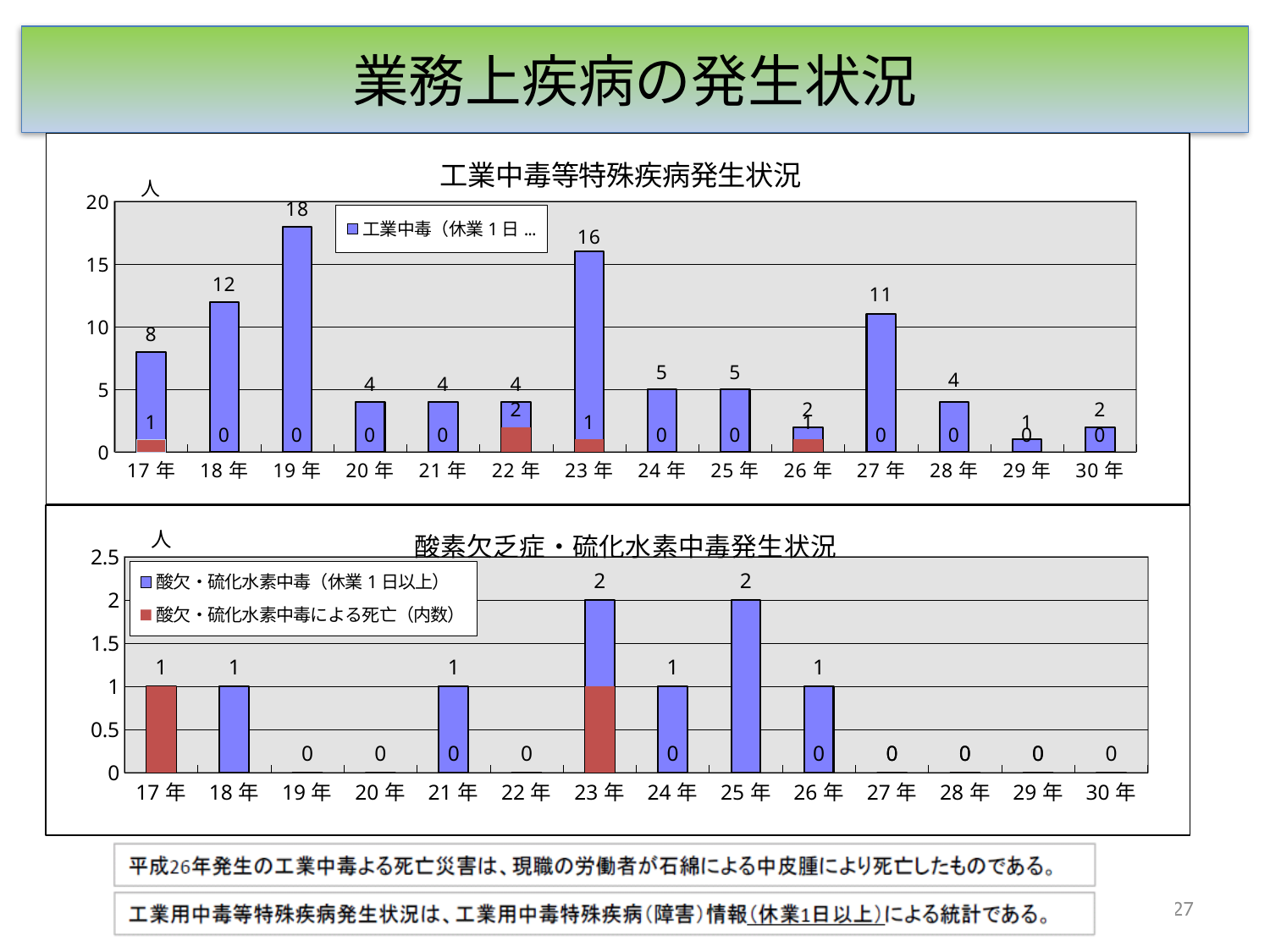
What kind of chart is the bottom chart (酸素欠乏症・硫化水素中毒発生状況)? Bar chart In the bottom chart (酸素欠乏症・硫化水素中毒発生状況), what is the value of the red bar for 23年? 1 What is the title of the top chart on the slide? 工業中毒等特殊疾病発生状況 In the top chart (工業中毒等特殊疾病発生状況), how many years are shown on the x axis? 14 In the top chart (工業中毒等特殊疾病発生状況), what is the value of the red bar for 22年? 2 In the bottom chart (酸素欠乏症・硫化水素中毒発生状況), what is the value of the blue bar for 25年? 2 In the top chart (工業中毒等特殊疾病発生状況), what is the difference between the blue bar values for 23年 and 18年? 4 In the top chart (工業中毒等特殊疾病発生状況), which is larger, the blue bar for 17年 or the blue bar for 24年? 17年 In the top chart (工業中毒等特殊疾病発生状況), what is the value of the blue bar for 19年? 18 In the top chart (工業中毒等特殊疾病発生状況), what is the value of the blue bar for 27年? 11 In the top chart (工業中毒等特殊疾病発生状況), which year has the highest blue bar? 19年 In the bottom chart (酸素欠乏症・硫化水素中毒発生状況), how many series does the legend list? 2